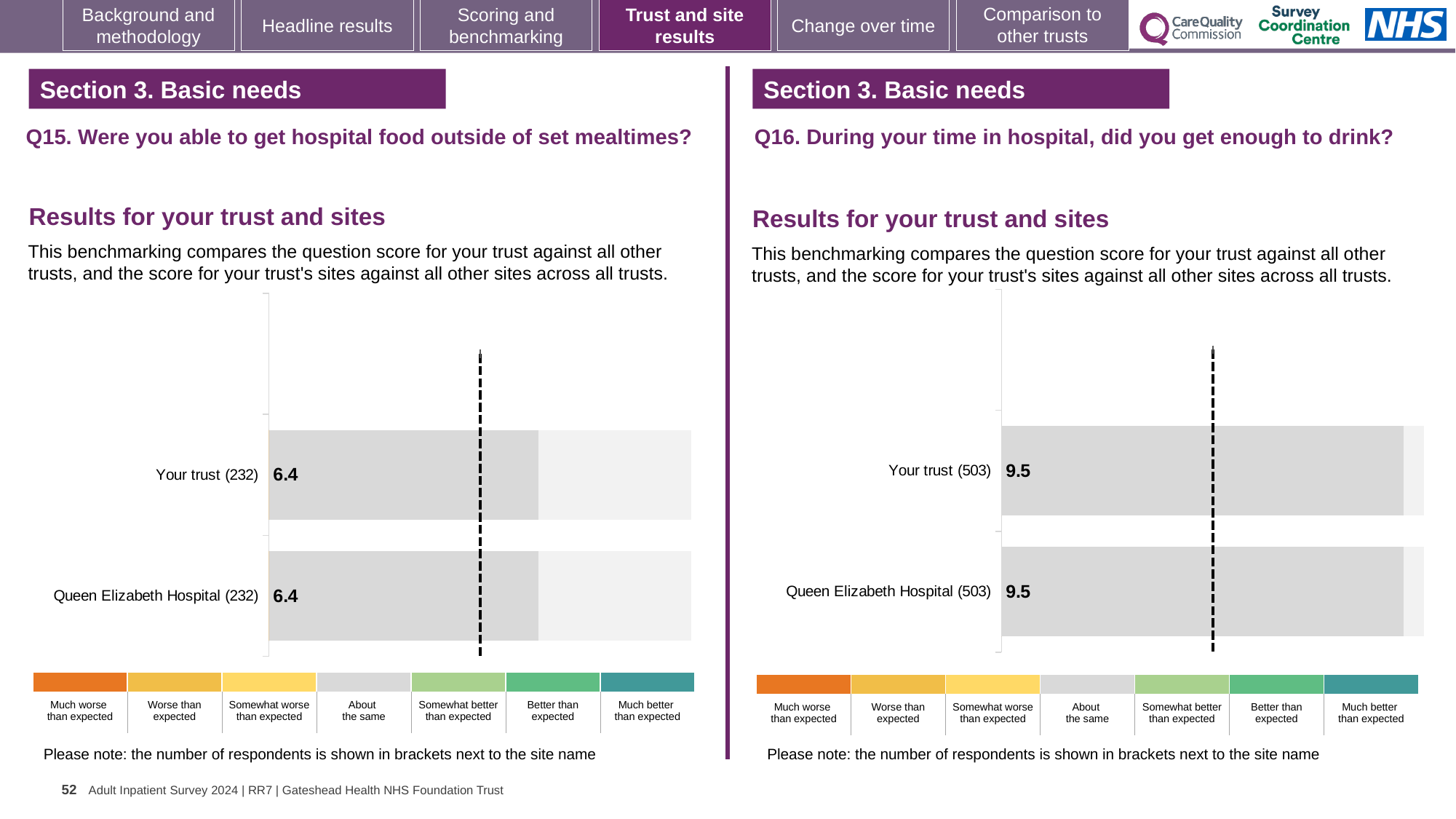
In the Q16 chart (right), how many respondents are shown in brackets for Queen Elizabeth Hospital? 503 What is the question title of the chart on the right? Q16. During your time in hospital, did you get enough to drink? In the Q15 chart (left), how many bars are plotted? 2 In the Q15 chart (left), what is the score for Queen Elizabeth Hospital? 6.4 In the Q15 chart (left), what is the score for Your trust? 6.4 In the Q15 chart (left), how many respondents are shown in brackets for Your trust? 232 In the Q15 chart (left), what is the difference between the score for Your trust and the score for Queen Elizabeth Hospital? 0.0 In the Q16 chart (right), what is the score for Queen Elizabeth Hospital? 9.5 In the Q16 chart (right), what is the score for Your trust? 9.5 In the Q16 chart (right), how many bars are plotted? 2 What kind of chart is used for the Q15 results on the left? Bar chart In the Q16 chart (right), which benchmark category does the grey colour of the bars correspond to in the legend? About the same